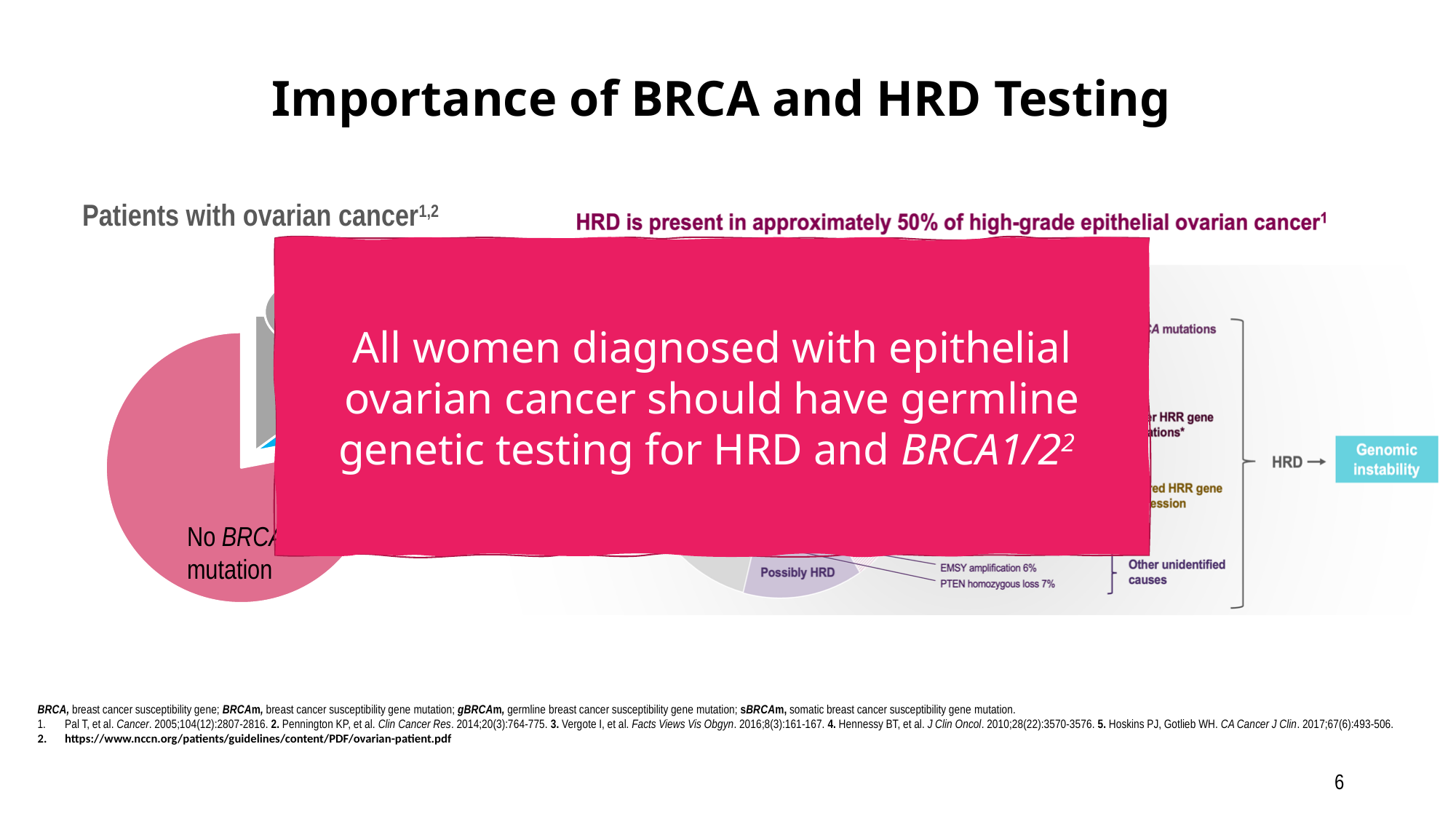
In the left pie chart titled 'Patients with ovarian cancer', what is the label of the large pink slice? No BRCA mutation What is the heading printed above the right-hand HRD chart? HRD is present in approximately 50% of high-grade epithelial ovarian cancer What kind of chart is shown on the left side of the slide under the heading 'Patients with ovarian cancer'? pie chart In the right-hand HRD chart, what percentage is given for EMSY amplification? 6% In the right-hand HRD chart, what does the arrow from 'HRD' point to? Genomic instability In the right-hand HRD chart, which is larger: EMSY amplification or PTEN homozygous loss? PTEN homozygous loss In the right-hand HRD chart, what percentage is given for PTEN homozygous loss? 7% In the right-hand HRD chart, what is the difference between the PTEN homozygous loss percentage and the EMSY amplification percentage? 1% In the right-hand HRD chart, is the value for PTEN homozygous loss greater or less than 10%? less